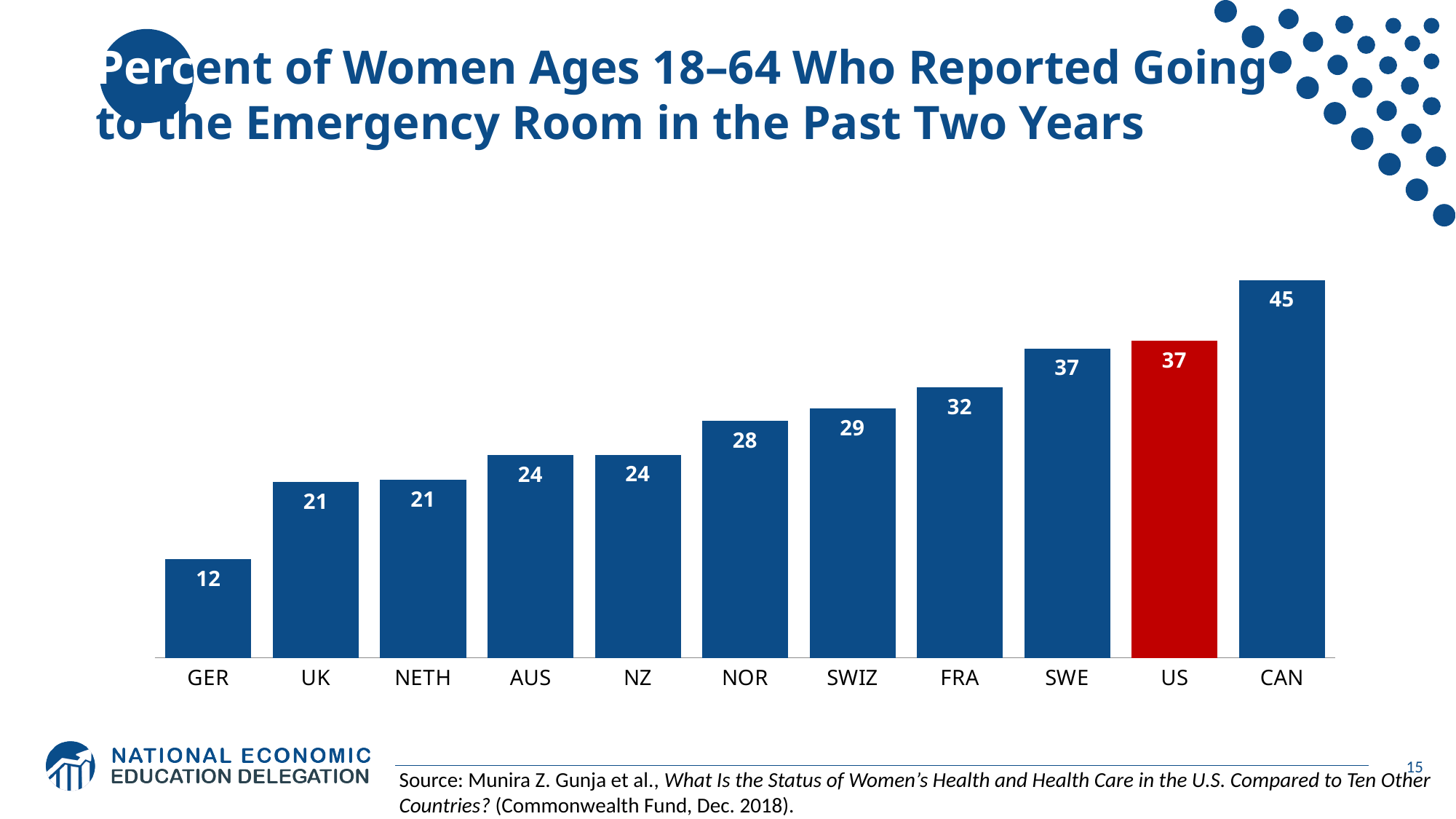
What is the value for GER? 12 Which is larger, the value for SWIZ or the value for AUS? SWIZ Which country has the lowest value? GER What kind of chart is shown on the slide? Bar chart Which country has the highest value? CAN What is the value for the US? 37 What is the difference between the values for CAN and the US? 8 Which country's bar is coloured red? US How many countries are shown in the chart? 11 Do the values rise or fall from left to right along the x axis? Rise What is the value for NOR? 28 What is the difference between the values for FRA and UK? 11